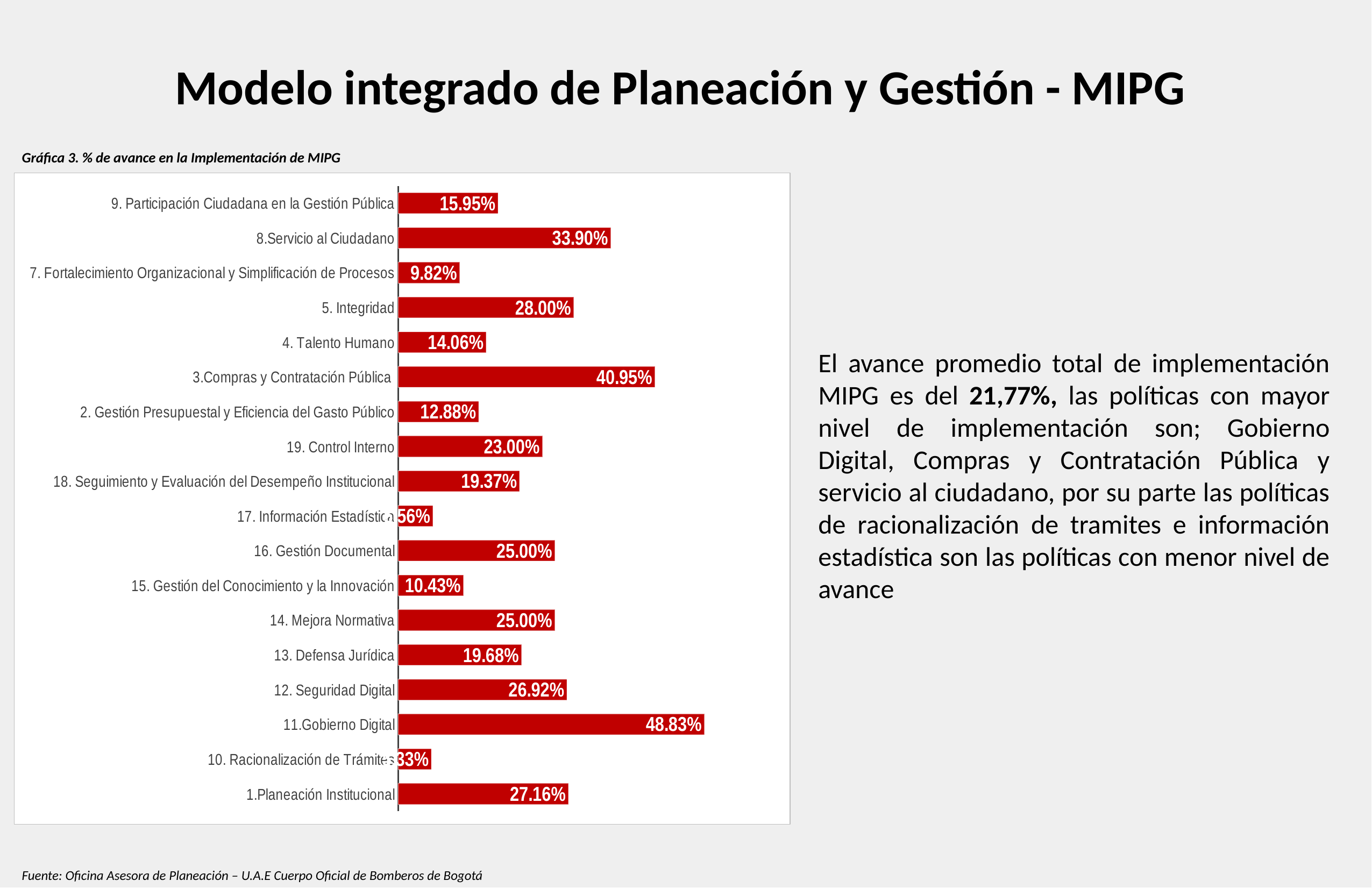
Which is larger, the value for 4. Talento Humano or the value for 2. Gestión Presupuestal y Eficiencia del Gasto Público? 4. Talento Humano Which category has the highest value? 11.Gobierno Digital What type of chart is shown on the slide? bar chart What is the value for 11.Gobierno Digital? 48.83% What is the value for 3.Compras y Contratación Pública? 40.95% What is the difference between the values for 11.Gobierno Digital and 3.Compras y Contratación Pública? 7.88% What is the difference between the values for 8.Servicio al Ciudadano and 5. Integridad? 5.90% What is the title of the chart? Gráfica 3. % de avance en la Implementación de MIPG What is the value for 1.Planeación Institucional? 27.16% How many categories (bars) does the chart show? 18 What is the value for 7. Fortalecimiento Organizacional y Simplificación de Procesos? 9.82% Which is larger, the value for 12. Seguridad Digital or the value for 19. Control Interno? 12. Seguridad Digital